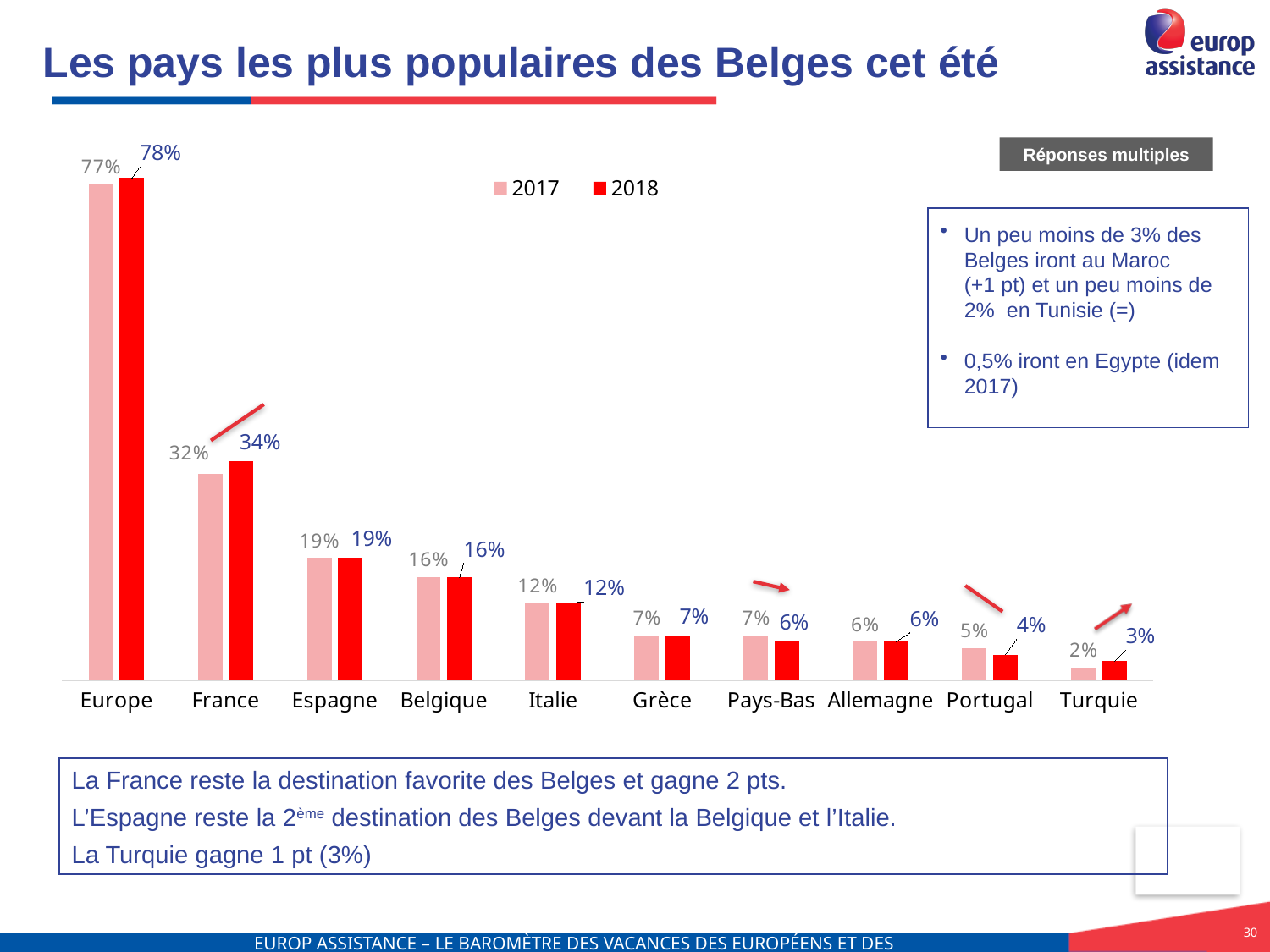
What is the 2017 value for Espagne? 19% What is the 2018 value for France? 34% What is the 2018 value for Turquie? 3% What is the difference between the 2018 and 2017 values for France? 2% How many series does the legend list? 2 Do the 2018 values rise or fall from Europe to Turquie along the x axis? Fall Which category has the lowest 2017 value? Turquie What kind of chart is shown on the slide? Bar chart Which is larger for Pays-Bas: the 2017 value or the 2018 value? 2017 Which category has the highest 2018 value? Europe How many categories are shown on the x axis? 10 What is the title of the slide's chart? Les pays les plus populaires des Belges cet été